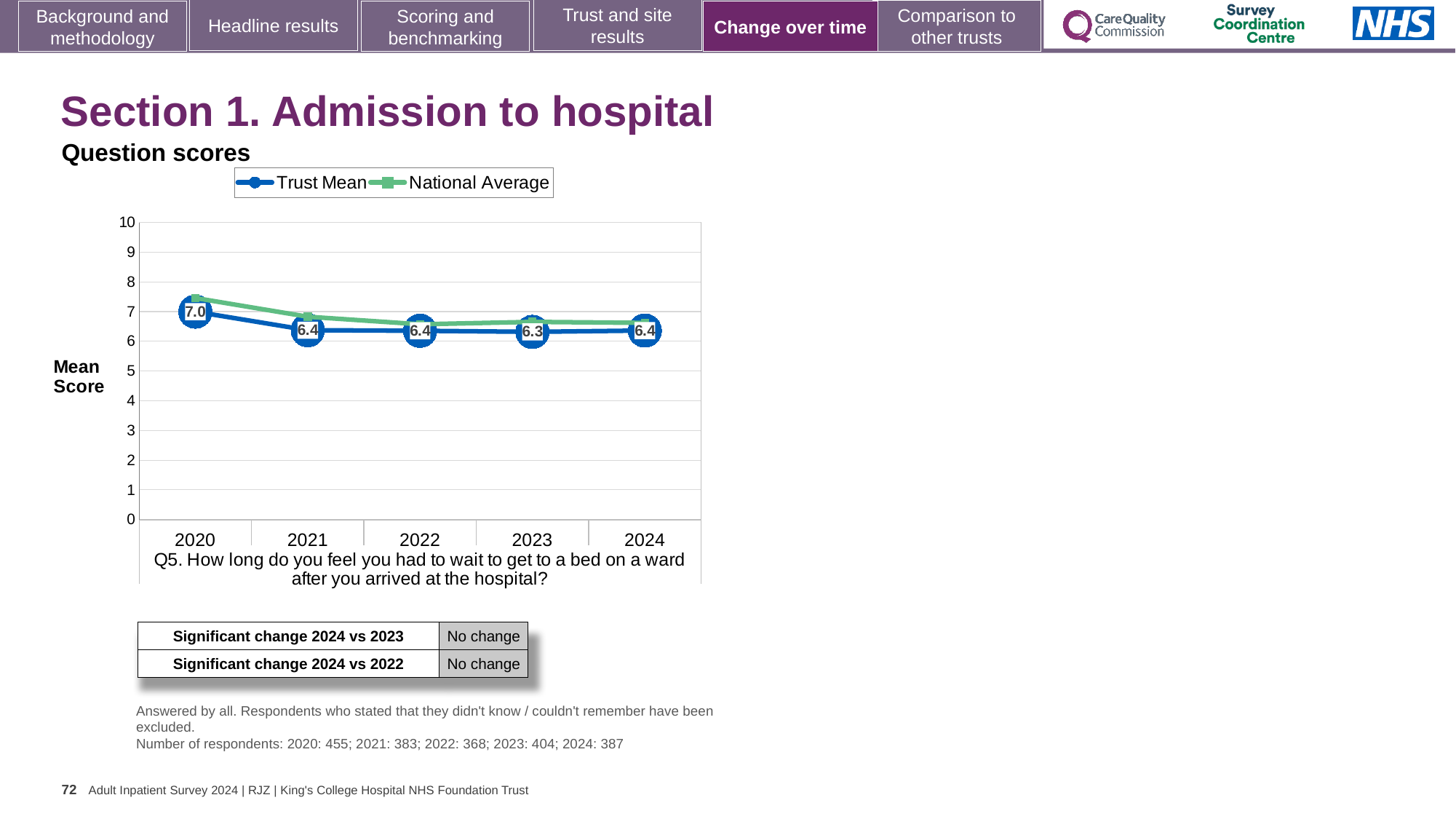
How many years are plotted on the x axis? 5 What is the Trust Mean score for 2023? 6.3 What is the difference between the Trust Mean score in 2020 and in 2021? 0.6 Does the Trust Mean score rise or fall from 2020 to 2021? Fall Is the National Average value for 2020 greater or less than 7? greater Which is larger, the Trust Mean score in 2020 or in 2024? 2020 What is the Trust Mean score for 2024? 6.4 In which year is the Trust Mean score highest? 2020 How many series does the legend list? 2 In which year is the Trust Mean score lowest? 2023 What kind of chart is shown on the slide? Line chart What is the Trust Mean score for 2020? 7.0